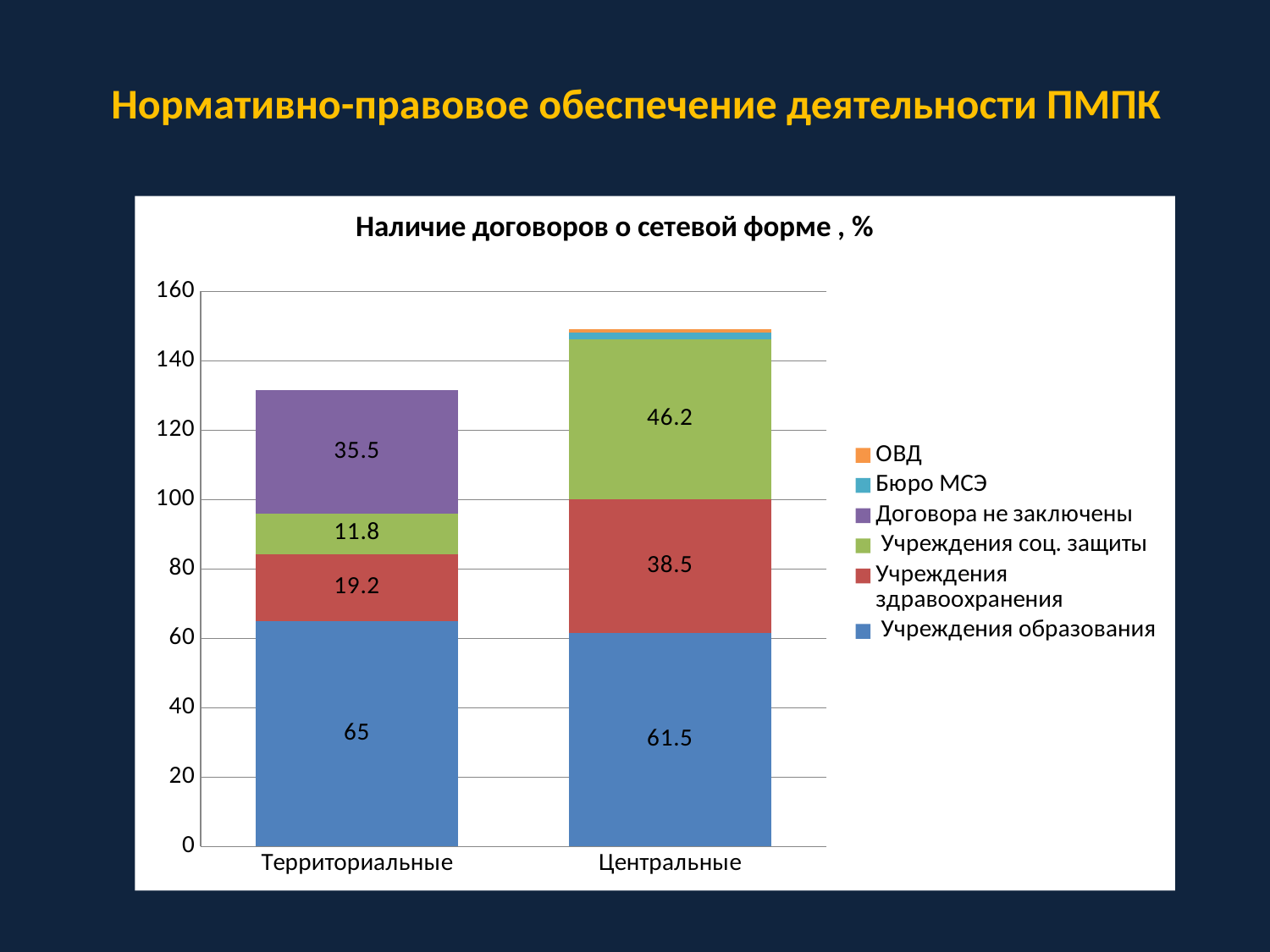
How many series does the legend list? 6 What is the value for Договора не заключены in the Территориальные bar? 35.5 Which segment is the largest in the Территориальные bar? Учреждения образования What is the difference between the Учреждения образования values for Территориальные and Центральные? 3.5 What is the value for Учреждения образования in the Территориальные bar? 65 What is the value for Учреждения соц. защиты in the Центральные bar? 46.2 Is the total height of the Центральные bar greater or less than 140? greater Which category has the larger value for Учреждения здравоохранения, Территориальные or Центральные? Центральные What is the value for Учреждения здравоохранения in the Центральные bar? 38.5 What is the total of the labelled segments in the Территориальные stacked bar? 131.5 What kind of chart is shown on the slide? stacked bar chart What is the difference between the Учреждения соц. защиты values for Центральные and Территориальные? 34.4